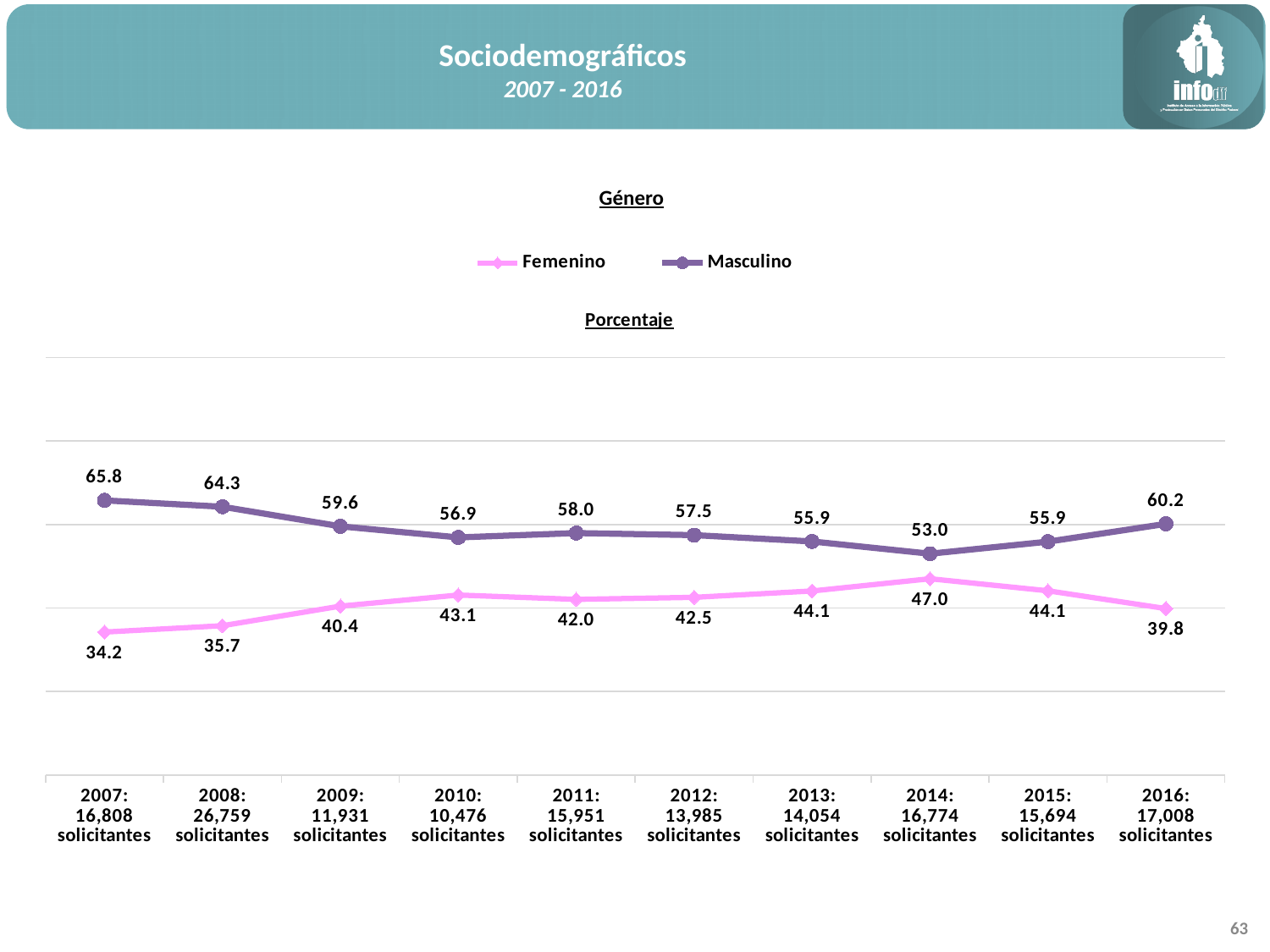
What is the difference between the Masculino and Femenino values in 2014? 6.0 What kind of chart is shown on the slide? Line chart What is the Masculino value for 2016? 60.2 In which year is the Masculino value lowest? 2014 In which year is the Femenino value lowest? 2007 How many years are shown on the x axis? 10 What is the Femenino value for 2014? 47.0 What is the difference between the Masculino and Femenino values in 2007? 31.6 Which series has the larger value in 2010, Femenino or Masculino? Masculino In which year is the Femenino value highest? 2014 What is the Masculino value for 2007? 65.8 How many series does the legend list? 2